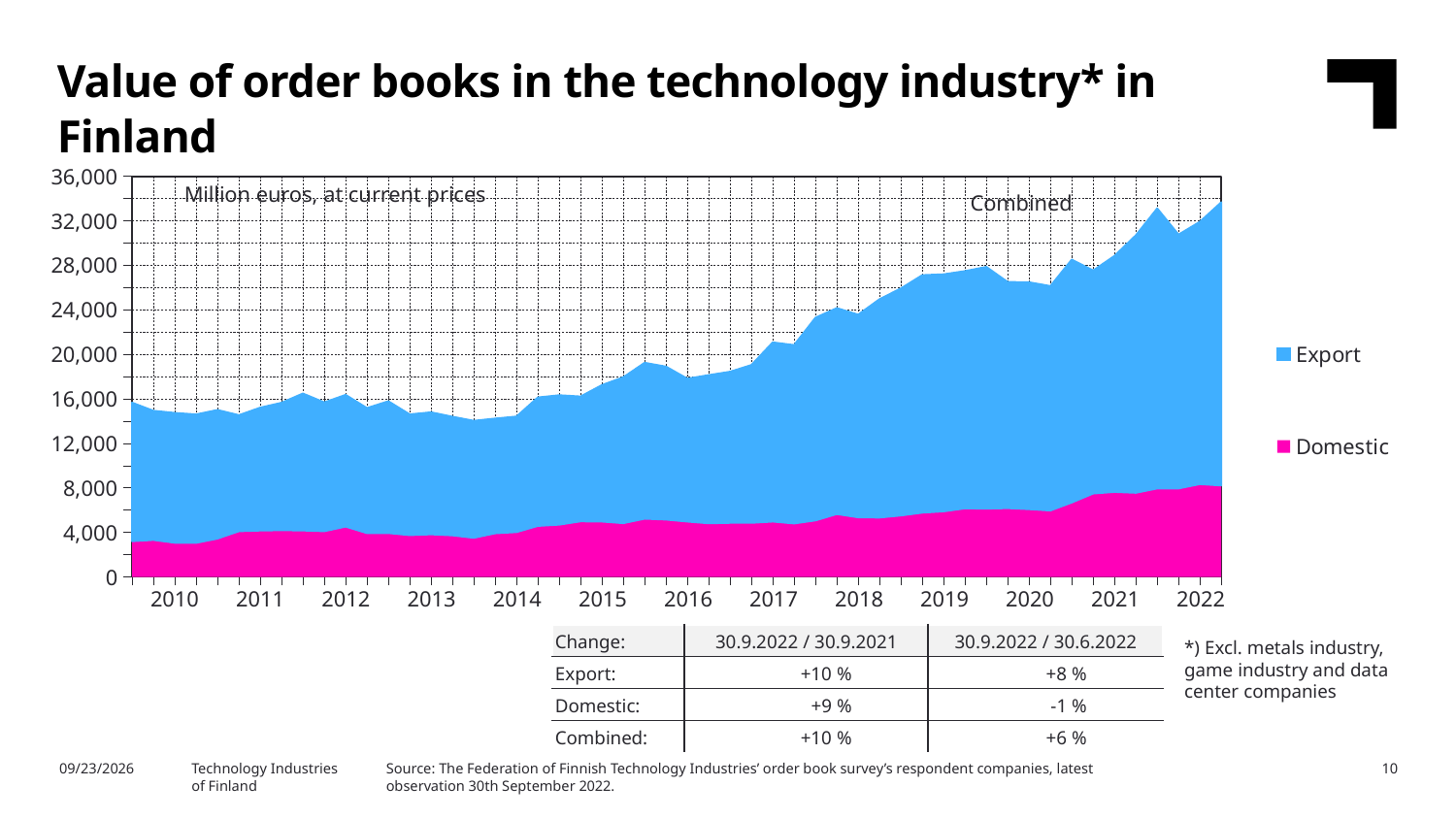
In 2022, which series is larger, Export or Domestic? Export In what unit are the values on the chart expressed, according to the label inside the plot area? Million euros, at current prices In which year shown on the x axis does the combined value of order books reach its highest level? 2022 Which two series are listed in the chart legend? Export and Domestic Is the combined value of order books in 2014 greater or less than 20,000? less Is the Domestic value at the start of 2010 greater or less than 4,000? less Does the combined value of order books generally rise or fall from 2010 to 2022? Rise Is the combined value of order books at the end of 2022 greater or less than 32,000? greater What kind of chart is shown on the slide? Stacked area chart How many years are labelled on the x axis of the chart? 13 How many series does the chart legend list? 2